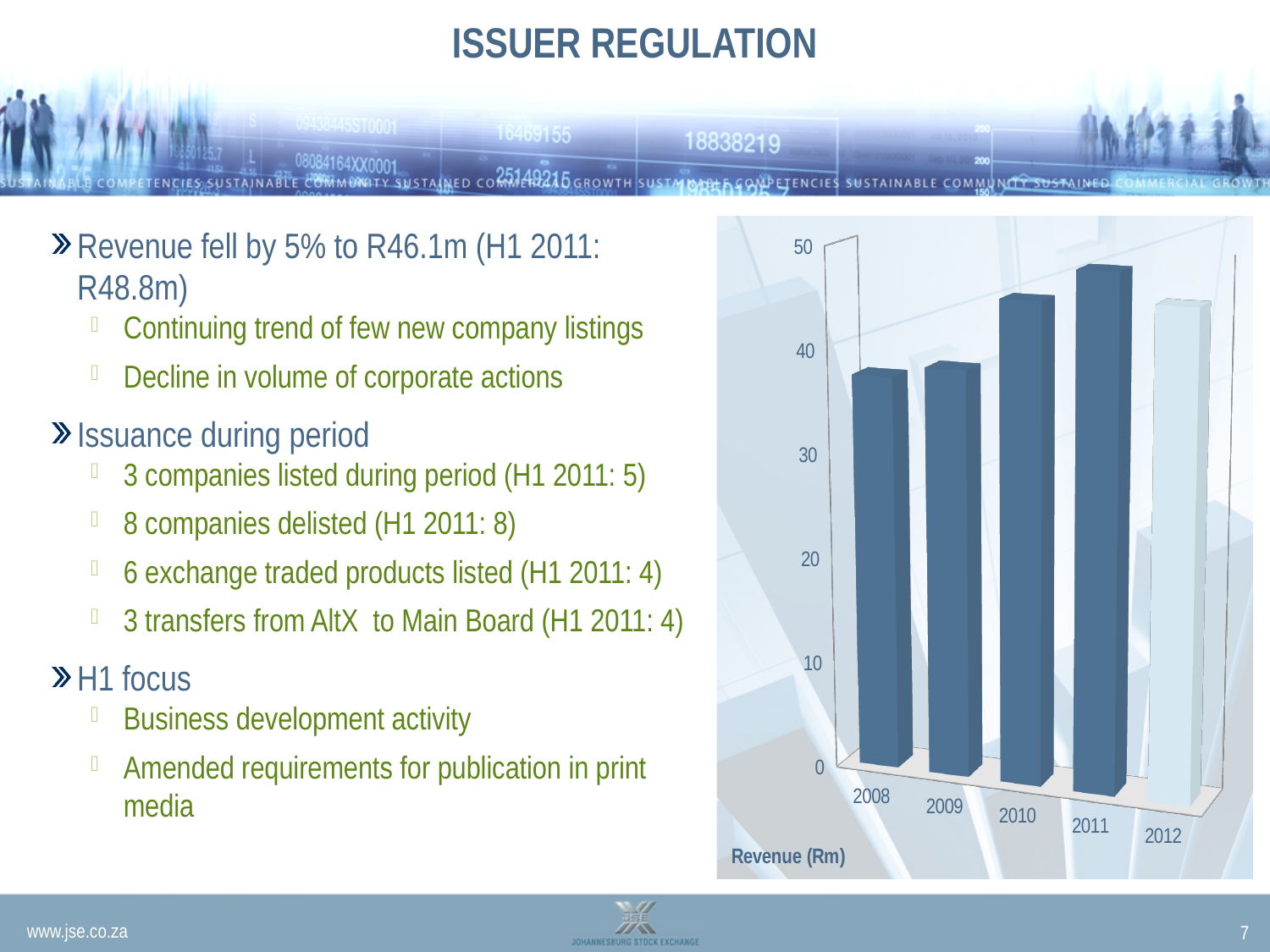
What kind of chart is shown on the slide? bar chart Does revenue rise or fall from 2008 to 2011? rise Is the revenue value for 2012 greater or less than 40? greater Is the revenue value for 2011 greater or less than 40? greater Which is larger, the revenue bar for 2010 or for 2009? 2010 Is the revenue value for 2009 greater or less than 30? greater What label is shown beneath the chart describing the plotted measure? Revenue (Rm) Which year has the highest revenue bar? 2011 How many years are plotted on the chart? 5 Which is larger, the revenue bar for 2011 or for 2008? 2011